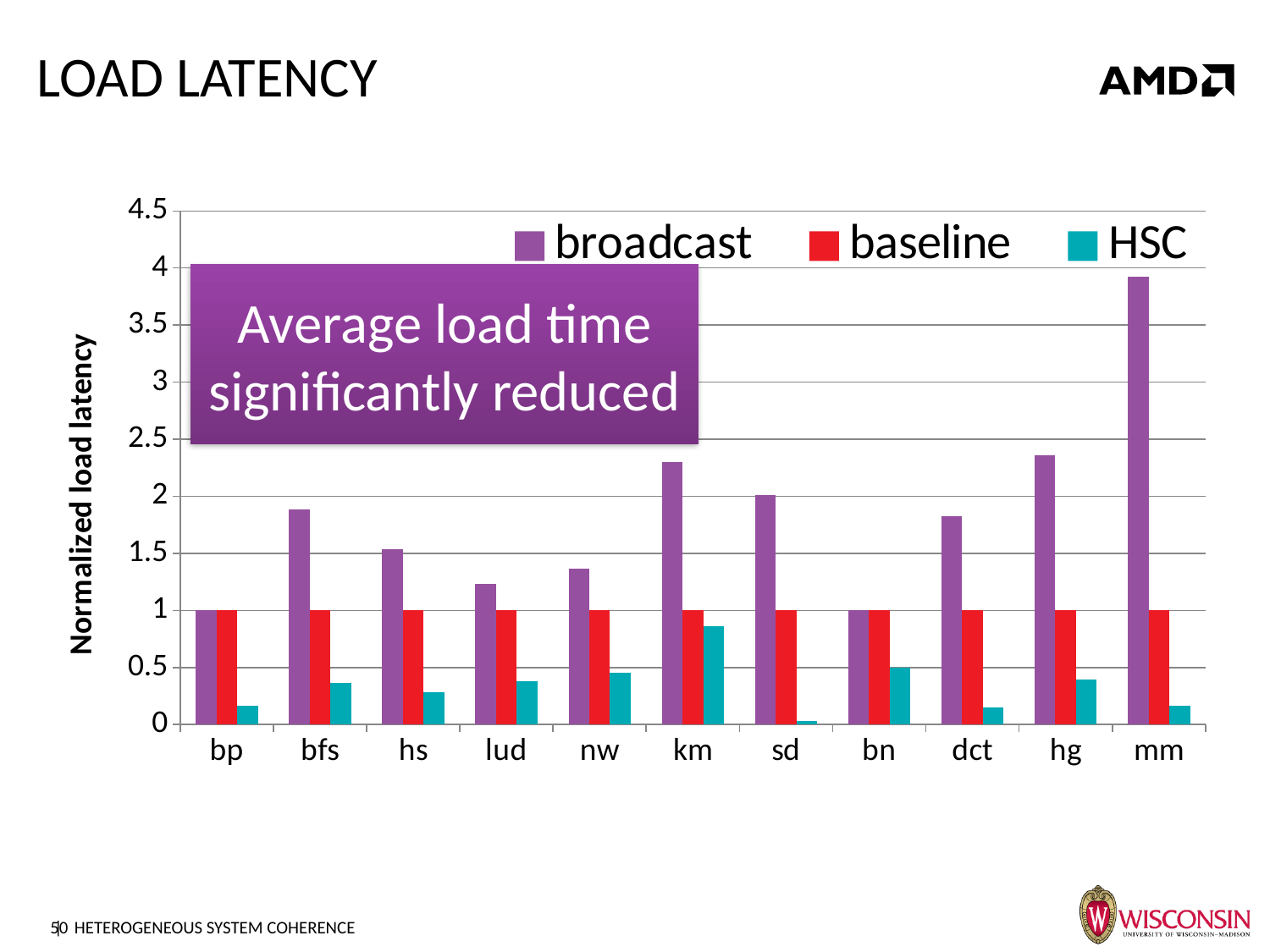
Which is larger, the broadcast value for km or the broadcast value for lud? km What is the baseline value for bfs? 1 How many categories are shown along the x axis? 11 How many series does the legend list? 3 Is the HSC value for km greater or less than 0.5? greater What is the label of the y axis? Normalized load latency Which category has the lowest HSC value? sd Is the broadcast value for hs greater or less than 2? less Is the broadcast value for mm greater or less than 3.5? greater Which is larger, the HSC value for bn or the HSC value for dct? bn Which category has the highest broadcast value? mm What kind of chart is shown on the slide? bar chart